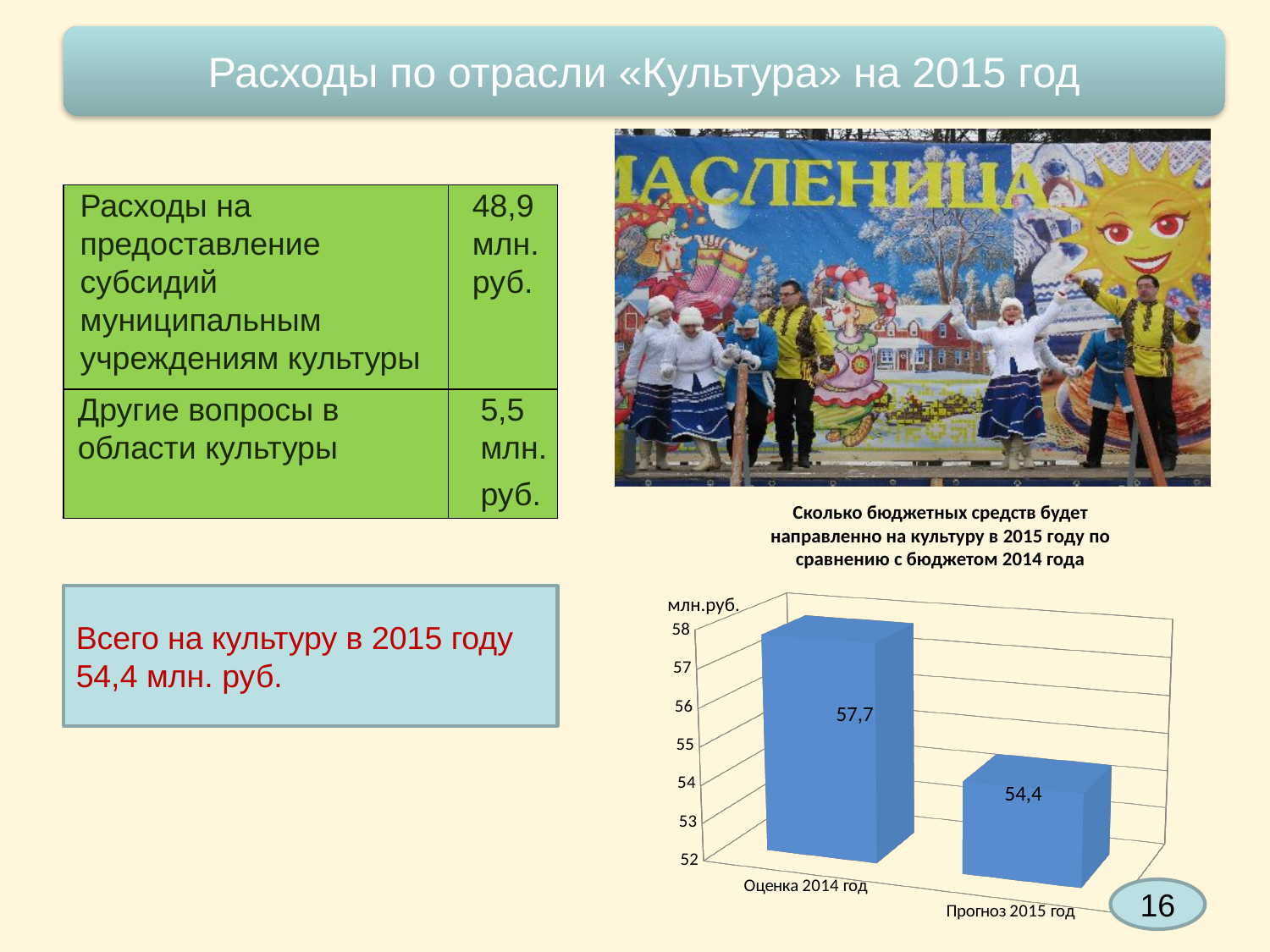
What is the value for Прогноз 2015 год on the chart? 54,4 What is the difference between the values for Оценка 2014 год and Прогноз 2015 год? 3,3 Is the value for Оценка 2014 год greater or less than 57? greater Is the value for Прогноз 2015 год greater or less than 55? less Which category has the lowest value on the chart? Прогноз 2015 год Which category has the highest value on the chart? Оценка 2014 год What kind of chart is shown on the slide? bar chart How many categories are shown on the chart? 2 Which is larger: the value for Оценка 2014 год or for Прогноз 2015 год? Оценка 2014 год What is the value for Оценка 2014 год on the chart? 57,7 Do the values rise or fall from Оценка 2014 год to Прогноз 2015 год? fall What unit is shown on the vertical axis of the chart? млн.руб.